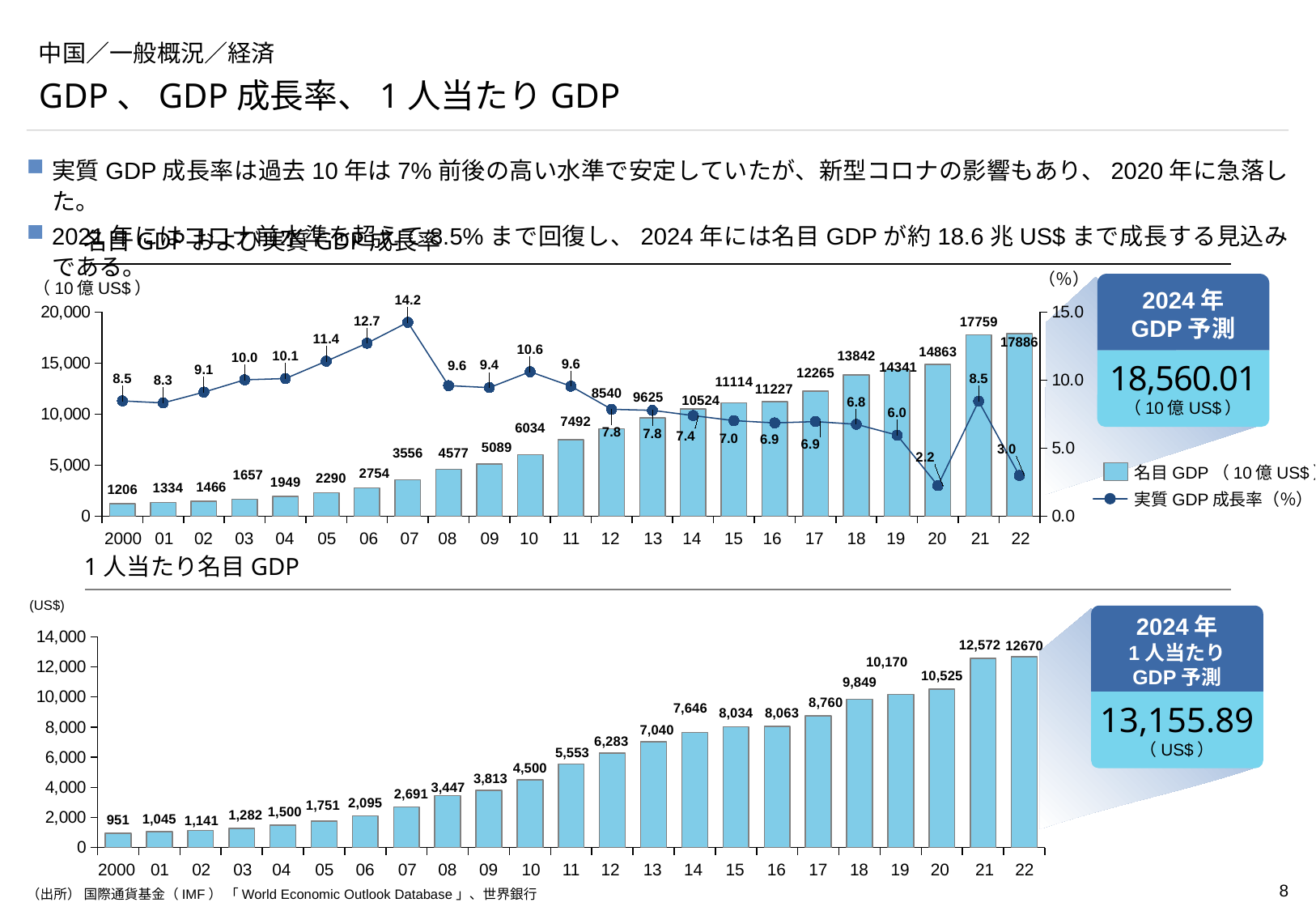
In the top chart (名目GDPおよび実質GDP成長率), what is the difference between the nominal GDP of 2021 and 2020? 2896 In the top chart (名目GDPおよび実質GDP成長率), which year has the lowest real GDP growth rate? 20 In the bottom chart (1人当たり名目GDP), what is the difference between the values for 2022 and 2021? 98 In the top chart (名目GDPおよび実質GDP成長率), which year has the highest real GDP growth rate? 07 In the top chart (名目GDPおよび実質GDP成長率), what is the real GDP growth rate for 2007? 14.2 In the bottom chart (1人当たり名目GDP), what is the value for 2018? 9,849 In the top chart (名目GDPおよび実質GDP成長率), is the real GDP growth rate for 2021 higher or lower than for 2022? higher In the bottom chart (1人当たり名目GDP), how many years are plotted? 23 In the top chart (名目GDPおよび実質GDP成長率), what is the nominal GDP value for 2022? 17886 In the bottom chart (1人当たり名目GDP), which year has the lowest value? 2000 In the top chart (名目GDPおよび実質GDP成長率), how many series does the legend list? 2 What type of chart is the bottom chart (1人当たり名目GDP)? bar chart